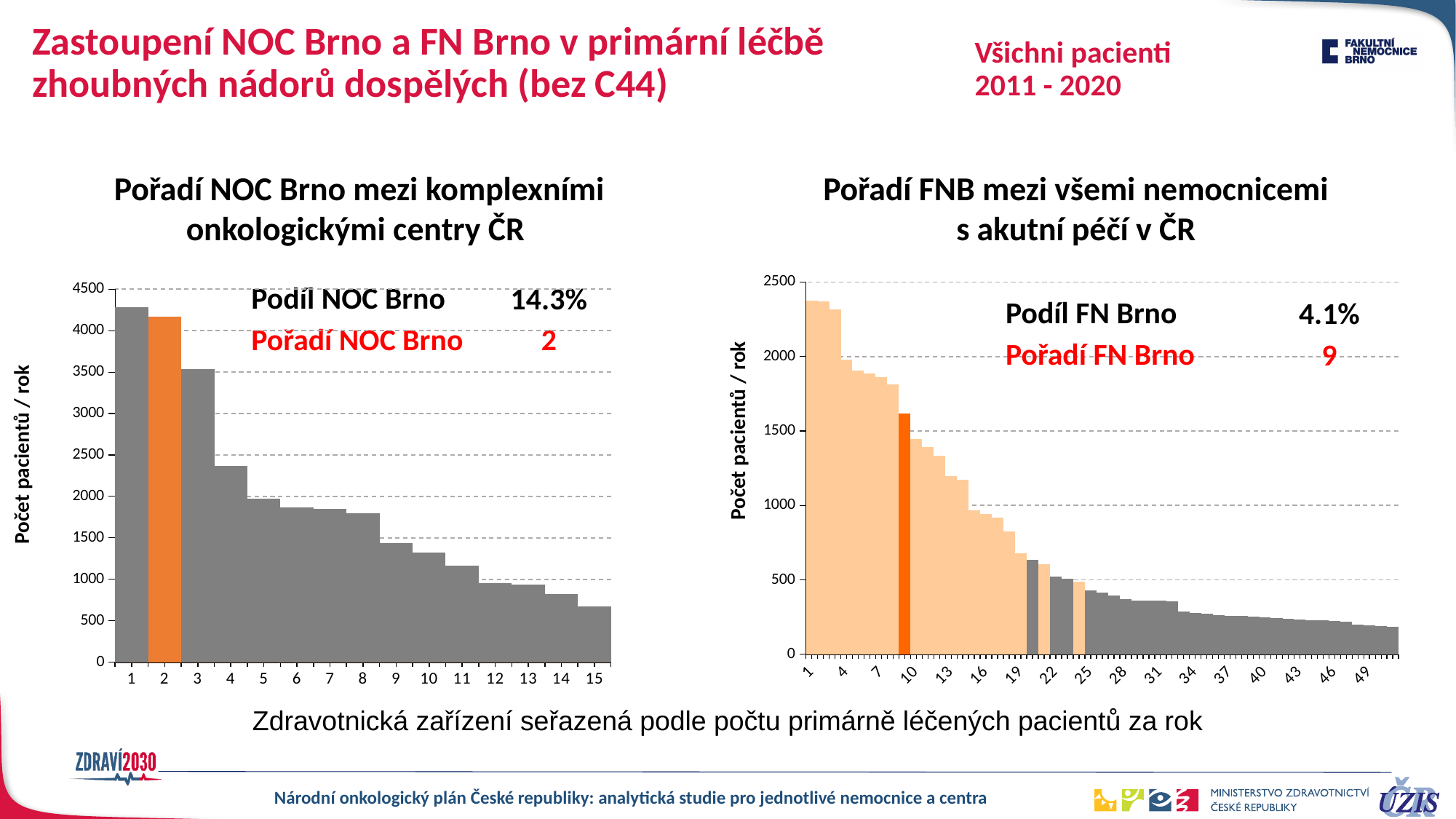
In the left chart, 'Pořadí NOC Brno mezi komplexními onkologickými centry ČR', is the value for category 15 greater or less than 500? greater In the left chart, 'Pořadí NOC Brno mezi komplexními onkologickými centry ČR', do the values rise or fall along the x axis? fall According to the text on the left chart, what is the share (Podíl) of NOC Brno? 14.3% In the right chart, 'Pořadí FNB mezi všemi nemocnicemi s akutní péčí v ČR', is the value for category 1 greater or less than 2500? less According to the text on the right chart, what is the rank (Pořadí) of FN Brno? 9 In the right chart, 'Pořadí FNB mezi všemi nemocnicemi s akutní péčí v ČR', is the value for the orange-highlighted bar (category 9) greater or less than 1500? greater In the left chart, 'Pořadí NOC Brno mezi komplexními onkologickými centry ČR', which category has the lowest value? 15 How many bars (categories) are shown in the left chart, 'Pořadí NOC Brno mezi komplexními onkologickými centry ČR'? 15 What kind of chart is the left chart, 'Pořadí NOC Brno mezi komplexními onkologickými centry ČR'? bar chart In the left chart, 'Pořadí NOC Brno mezi komplexními onkologickými centry ČR', which category has the highest value? 1